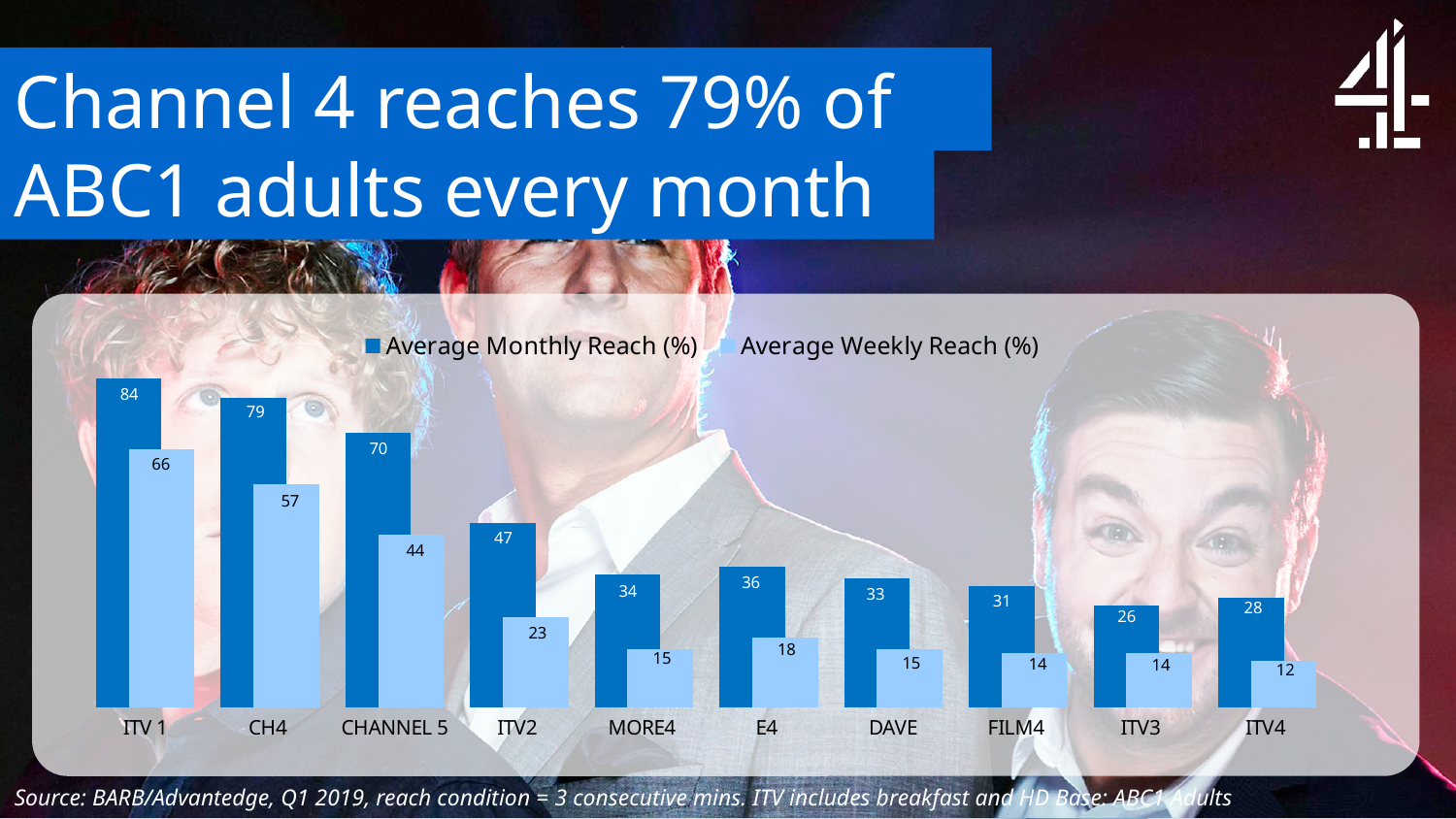
What is the Average Monthly Reach (%) for CH4? 79 What is the Average Weekly Reach (%) for ITV 1? 66 What is the difference in Average Weekly Reach (%) between ITV 1 and CH4? 9 What is the difference between the Average Monthly Reach (%) and the Average Weekly Reach (%) for CHANNEL 5? 26 Which channel has the lowest Average Weekly Reach (%)? ITV4 Which series is shown in the darker blue colour? Average Monthly Reach (%) How many series does the legend list? 2 Which has the larger Average Monthly Reach (%), E4 or MORE4? E4 Which channel has the highest Average Monthly Reach (%)? ITV 1 What is the Average Weekly Reach (%) for ITV4? 12 What kind of chart is shown on the slide? Bar chart How many channels are shown on the chart? 10